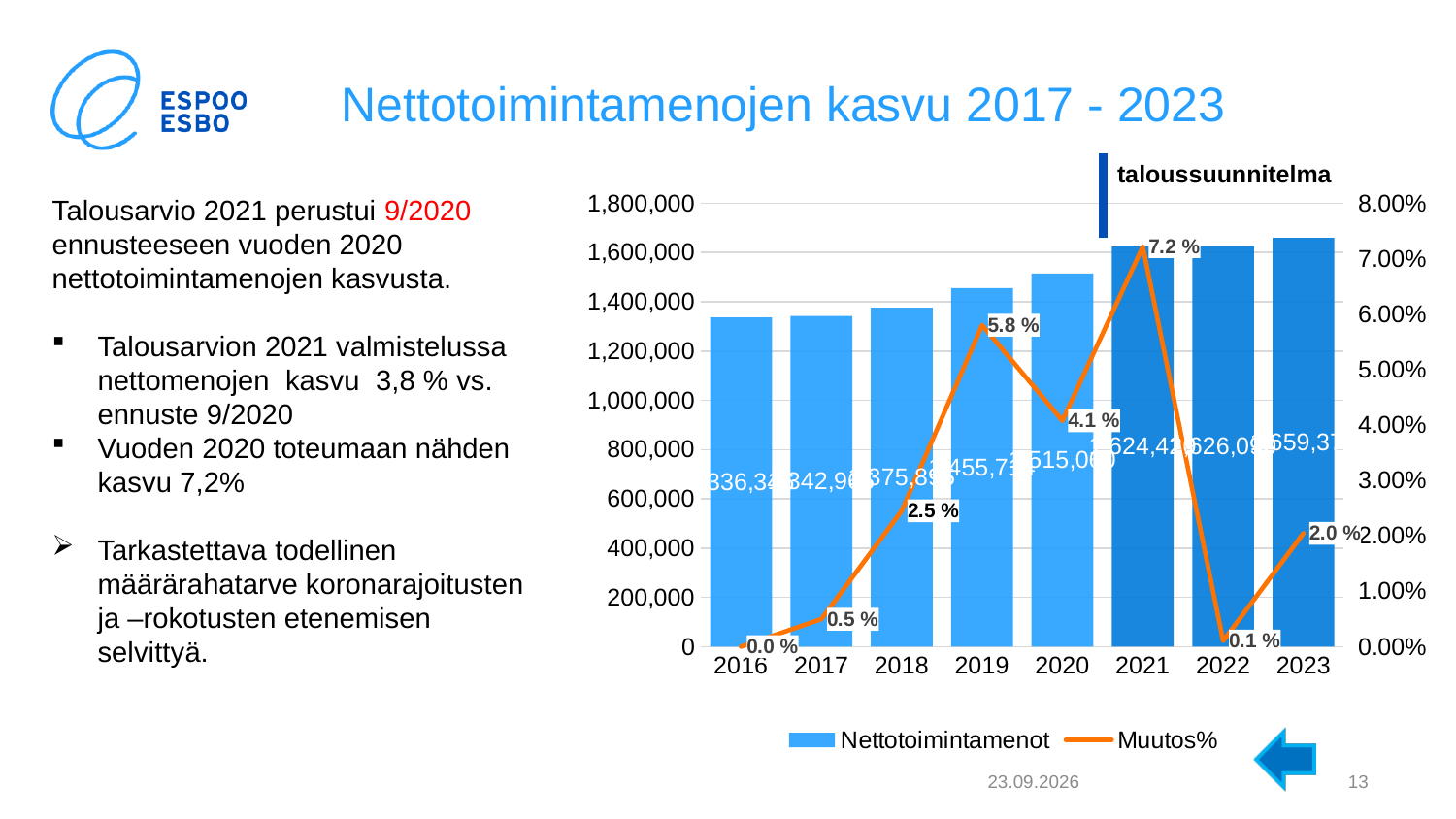
What is the Muutos% value for 2017? 0.5 % Which year has the larger Muutos% value, 2020 or 2023? 2020 Which year has the lowest Muutos% value? 2016 Does the Muutos% line rise or fall from 2016 to 2019? rise What is the Muutos% value for 2019? 5.8 % How many series does the chart legend list? 2 Is the Nettotoimintamenot bar for 2023 greater or less than 1,800,000? less What is the Muutos% value for 2021? 7.2 % How many years are shown on the x axis of the chart? 8 Which year has the highest Muutos% value? 2021 What is the difference between the Muutos% values for 2021 and 2019? 1.4 % Is the Nettotoimintamenot bar for 2016 greater or less than 1,200,000? greater